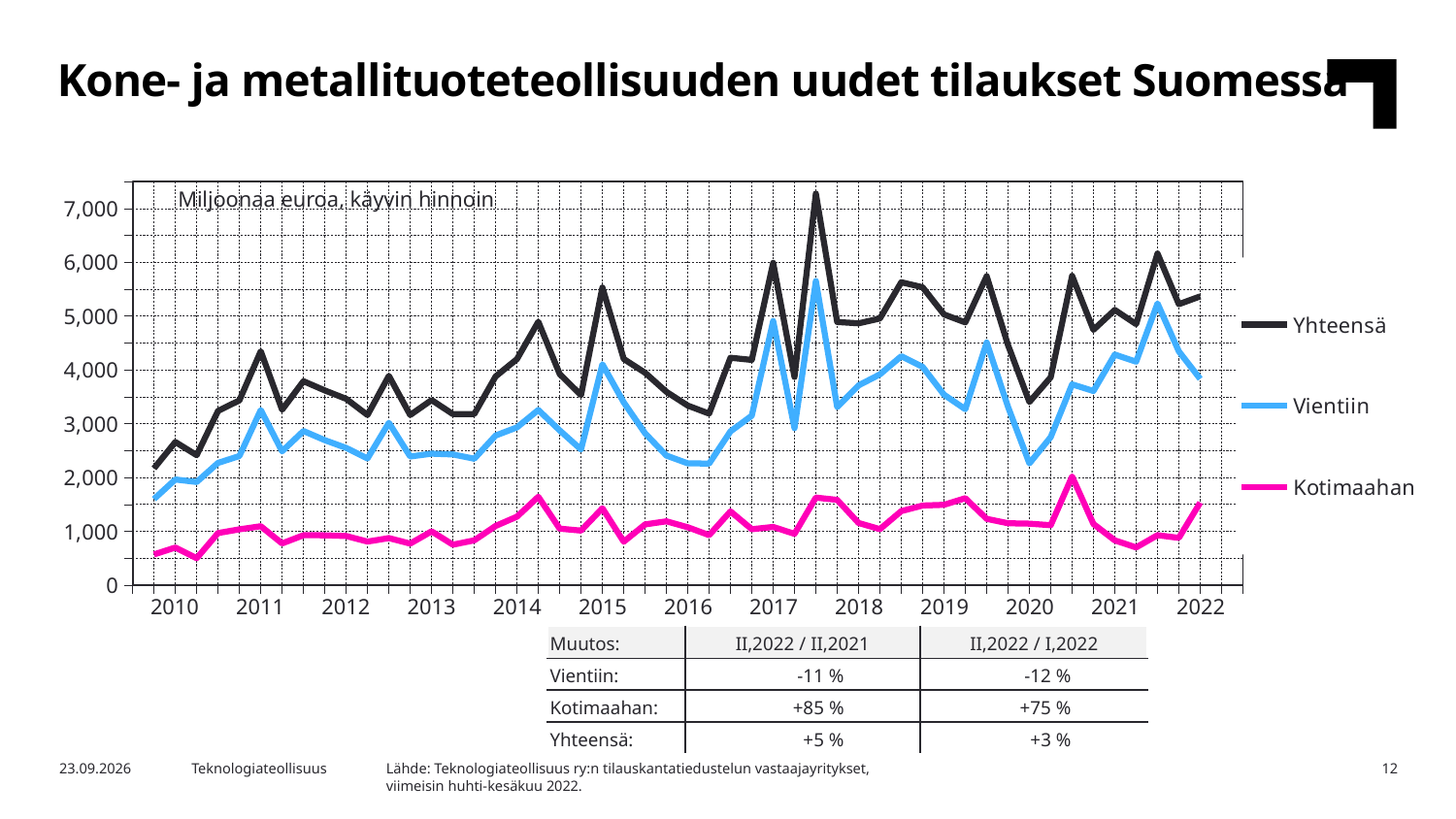
What unit does the chart state for its values? Miljoonaa euroa, käyvin hinnoin How many series does the chart legend list? 3 How many year labels are shown on the x axis? 13 Which series has the lowest values across the whole period? Kotimaahan Which is larger at the end of 2022, Vientiin or Kotimaahan? Vientiin Which series is shown with the black line? Yhteensä Is the value for Kotimaahan at the start of 2010 greater or less than 1,000? less Is the peak value of the Yhteensä line (around 2017–2018) greater or less than 7,000? greater What kind of chart is shown on the slide? line chart Does the Vientiin line rise or fall between 2019 and 2020? fall Is the value for Vientiin at the start of 2010 greater or less than 2,000? less Which series has the highest values across the whole period? Yhteensä